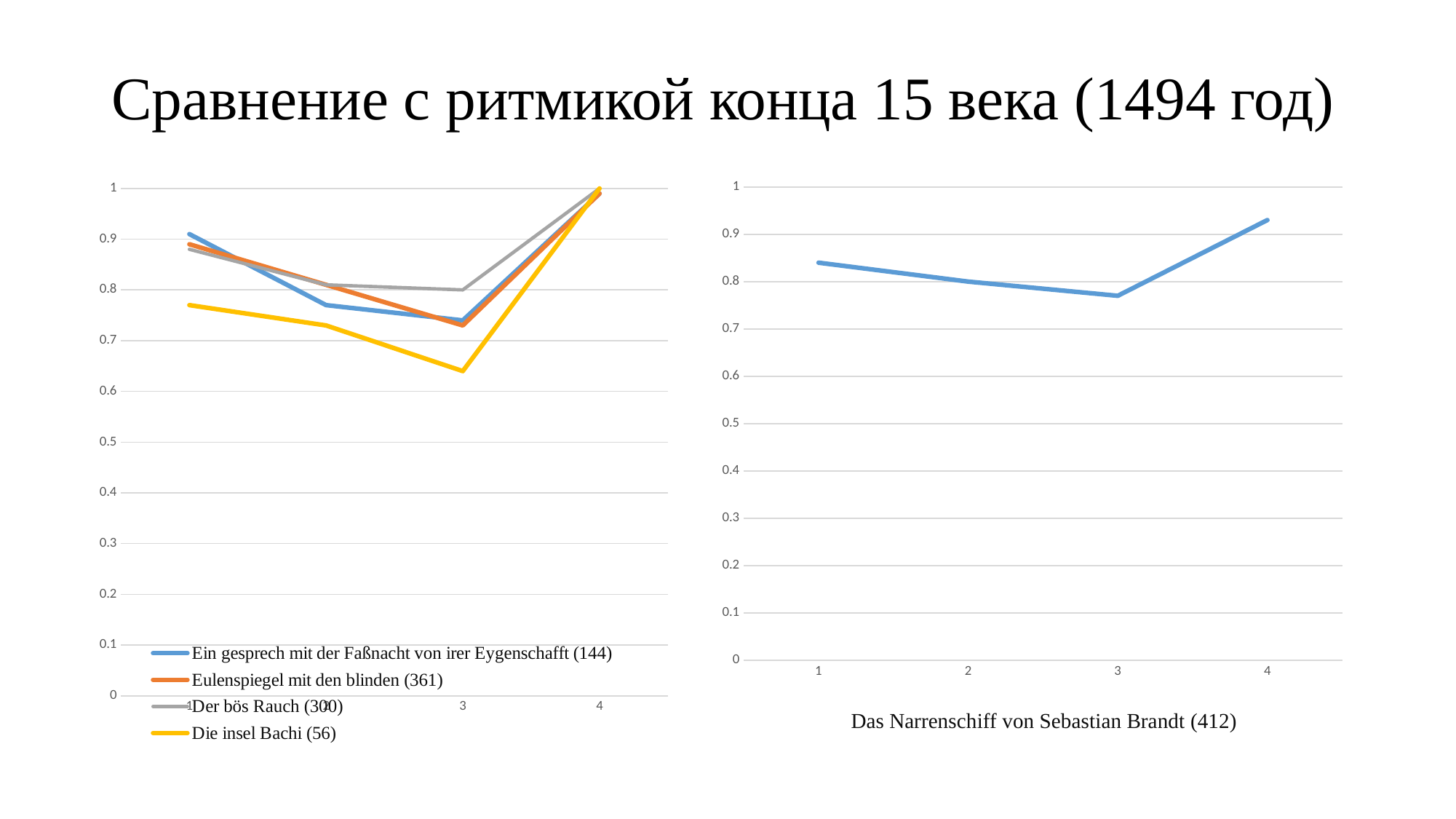
How many series does the legend of the left chart list? 4 How many points are plotted along the x axis of the right chart (Das Narrenschiff von Sebastian Brandt)? 4 In the left chart, is the value of Die insel Bachi (56) at x = 3 greater or less than 0.7? less In the right chart (Das Narrenschiff von Sebastian Brandt), at which x value is the line highest? 4 In the right chart (Das Narrenschiff von Sebastian Brandt), is the value at x = 3 greater or less than 0.8? less What kind of chart is the chart on the left of the slide? line chart What is the label given below the right chart? Das Narrenschiff von Sebastian Brandt (412) In the left chart, which series has the lowest value at x = 3? Die insel Bachi (56) In the right chart (Das Narrenschiff von Sebastian Brandt), does the line rise or fall from x = 1 to x = 3? fall In the left chart, is the value of Die insel Bachi (56) at x = 1 greater or less than 0.8? less In the left chart, which series has the highest value at x = 3? Der bös Rauch (300)